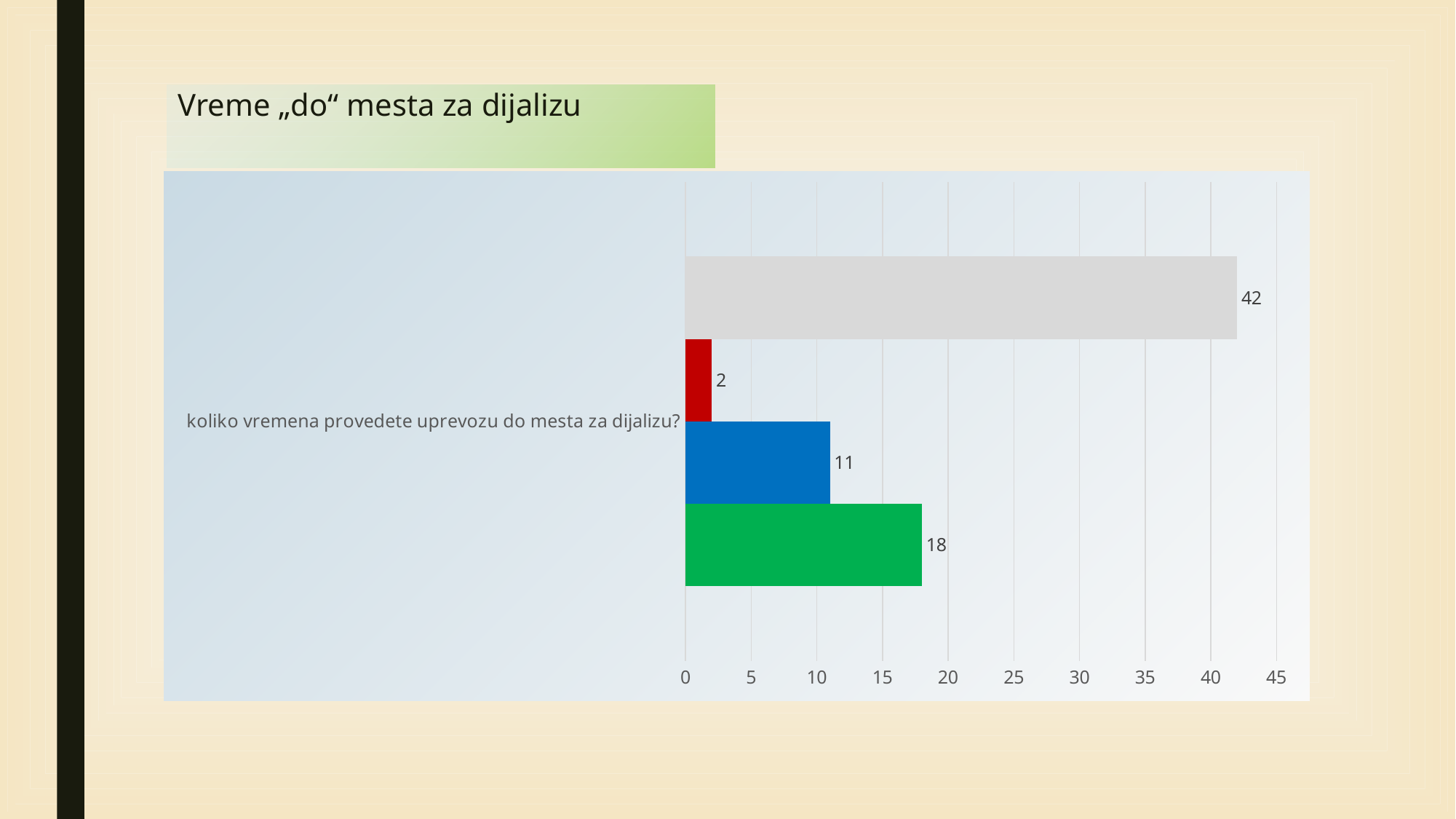
What is the value of the gray bar? 42 Is the value of the blue bar greater or less than 15? less Which bar has the lowest value? the red bar (2) What is the value of the blue bar? 11 What is the title of the slide? Vreme „do“ mesta za dijalizu What is the value of the red bar? 2 How many bars are plotted in the chart? 4 What is the difference between the gray bar and the green bar? 24 Which is larger, the blue bar or the green bar? the green bar Which bar has the highest value? the gray bar (42) What is the value of the green bar? 18 What type of chart is shown on the slide? bar chart